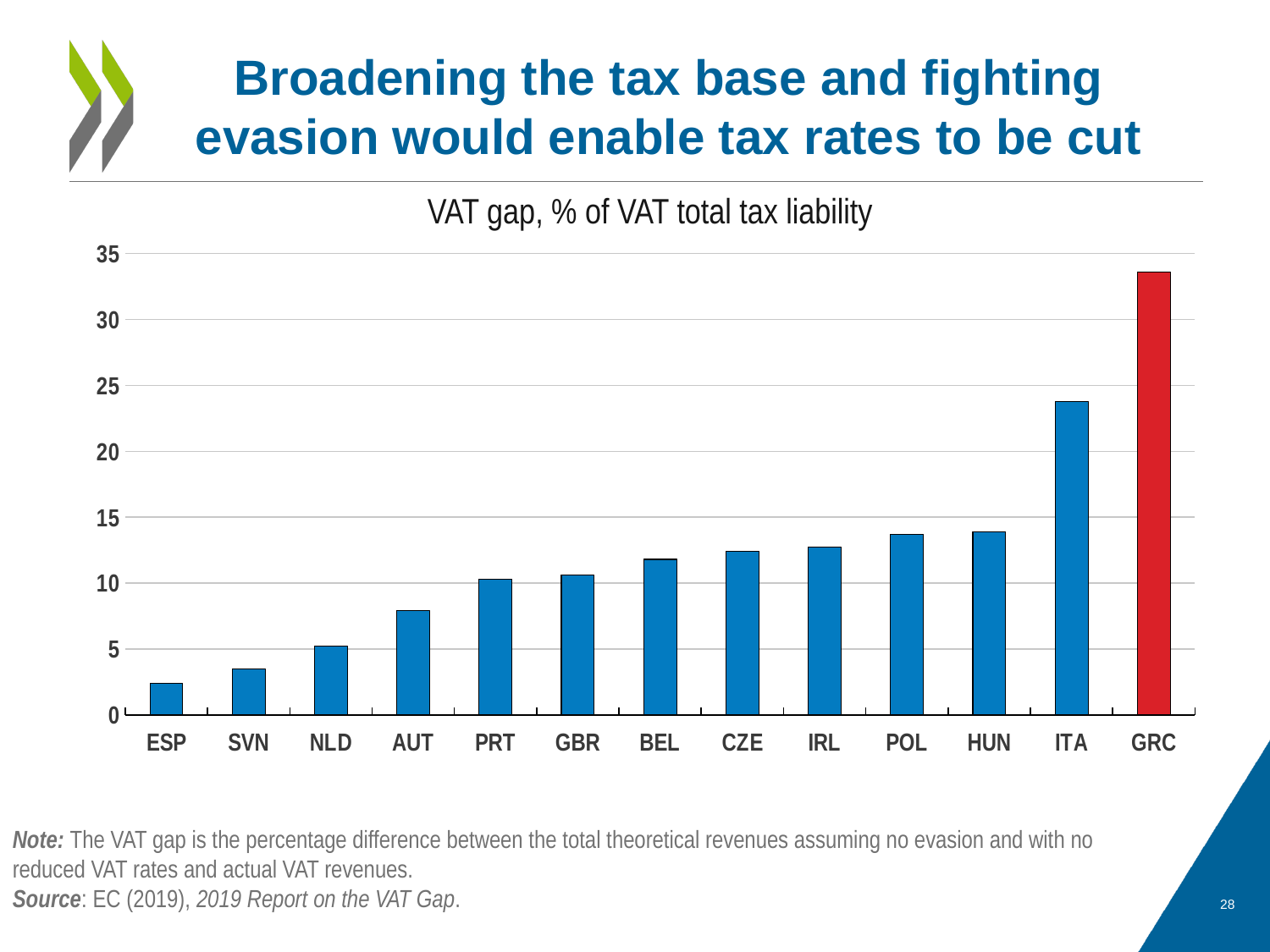
Is the value for AUT greater or less than 10? less Is the value for HUN greater or less than 15? less How many countries are shown on the x axis of the chart? 13 Which country has the highest VAT gap in the chart? GRC Which country has the lowest VAT gap in the chart? ESP Is the value for ITA greater or less than 25? less What kind of chart is shown on the slide? bar chart Do the bar values rise or fall moving from left to right along the x axis? rise What is the title of the chart? VAT gap, % of VAT total tax liability Which has a larger VAT gap, ITA or HUN? ITA